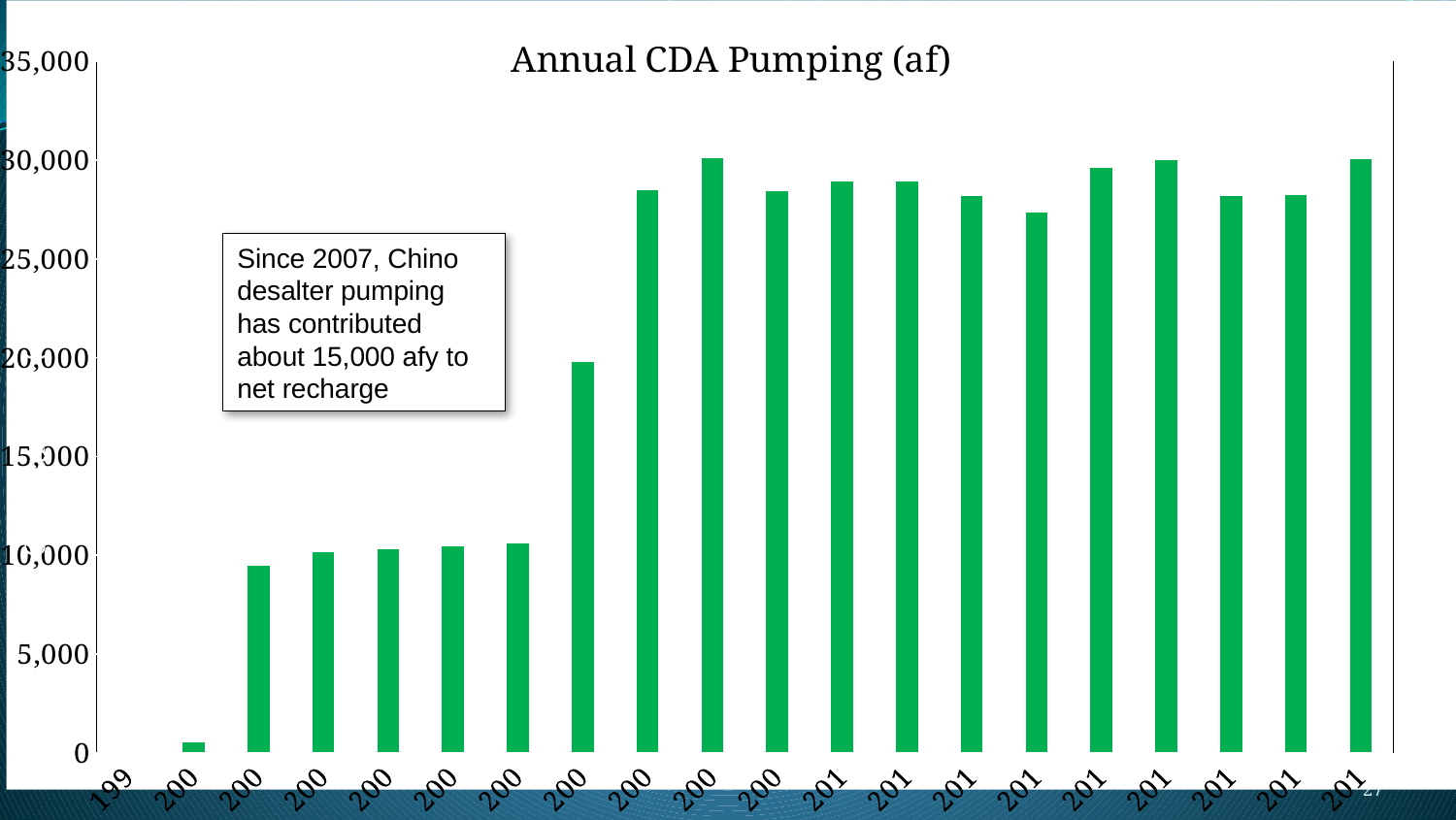
Is the value of the rightmost bar greater or less than 25,000? greater What is the title of the chart? Annual CDA Pumping (af) Overall, do the values rise or fall from left to right along the x axis? Rise What colour are the bars in the chart? Green Which is larger, the value of the leftmost bar or the value of the rightmost bar? The rightmost bar Is the value of the eighth bar from the left greater or less than 25,000? greater What is the highest value shown on the y axis? 35,000 Is the value of the leftmost (smallest) bar greater or less than 5,000? less How many data series are plotted in the chart? 1 What kind of chart is shown on the slide? Bar chart